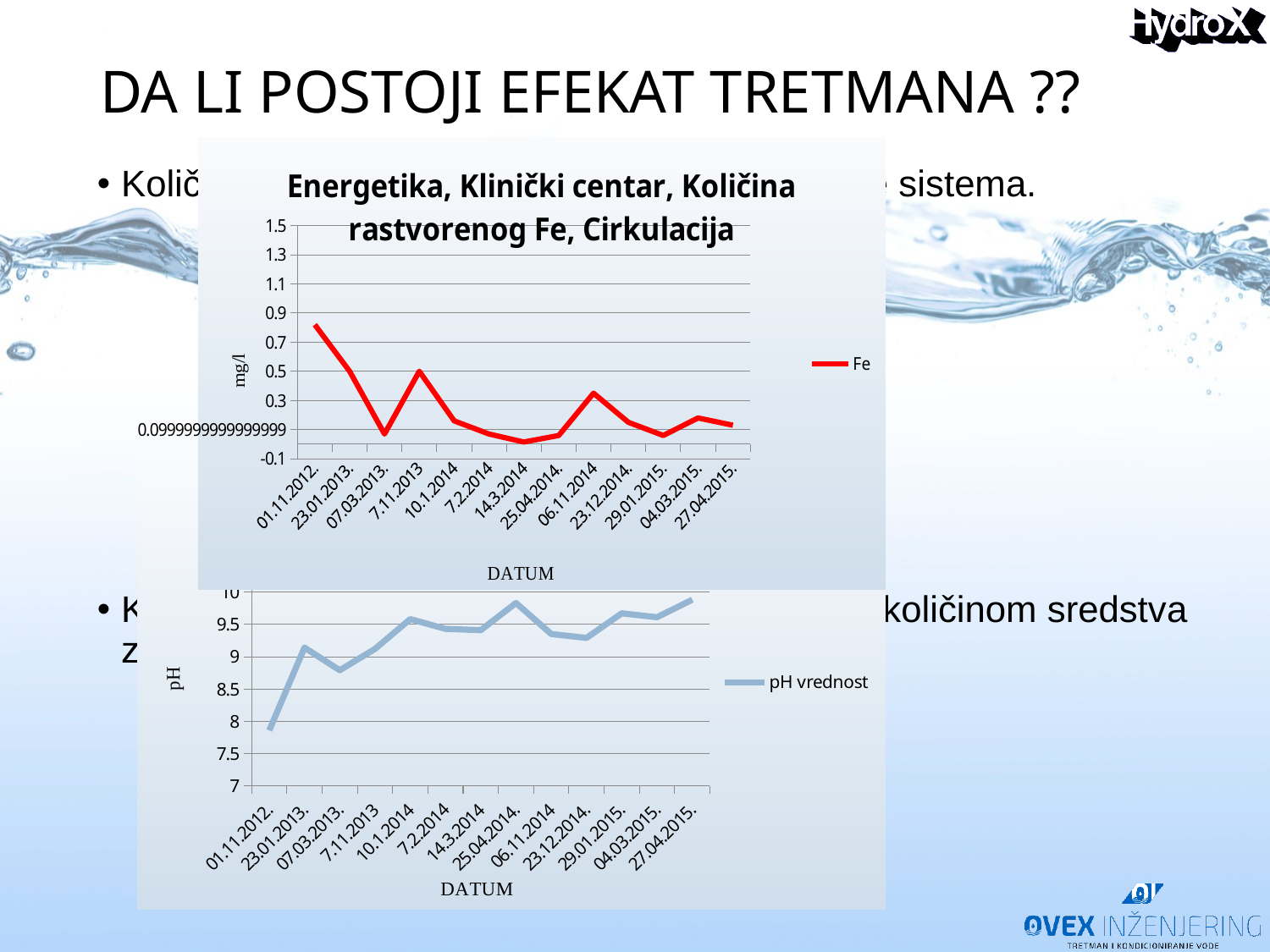
What series name is shown in the legend of the bottom chart? pH vrednost In the bottom chart (pH), do the pH values generally rise or fall from 01.11.2012. to 27.04.2015.? rise What type of chart is the top chart titled 'Energetika, Klinički centar, Količina rastvorenog Fe, Cirkulacija'? line chart In the top chart (Fe), which date has the larger Fe value, 01.11.2012. or 07.03.2013.? 01.11.2012. In the top chart (Fe), is the Fe value for 01.11.2012. greater or less than 0.5? greater In the top chart (Fe), on which date is the Fe value highest? 01.11.2012. What is the y-axis label of the top chart (Fe)? mg/l In the bottom chart (pH), on which date is the pH value lowest? 01.11.2012. In the bottom chart (pH), is the pH value for 01.11.2012. greater or less than 8? less How many series does the legend of the top chart (Fe) list? 1 How many dates are plotted on the x axis of the top chart (Fe)? 13 In the top chart (Fe), is the Fe value for 06.11.2014 greater or less than 0.5? less